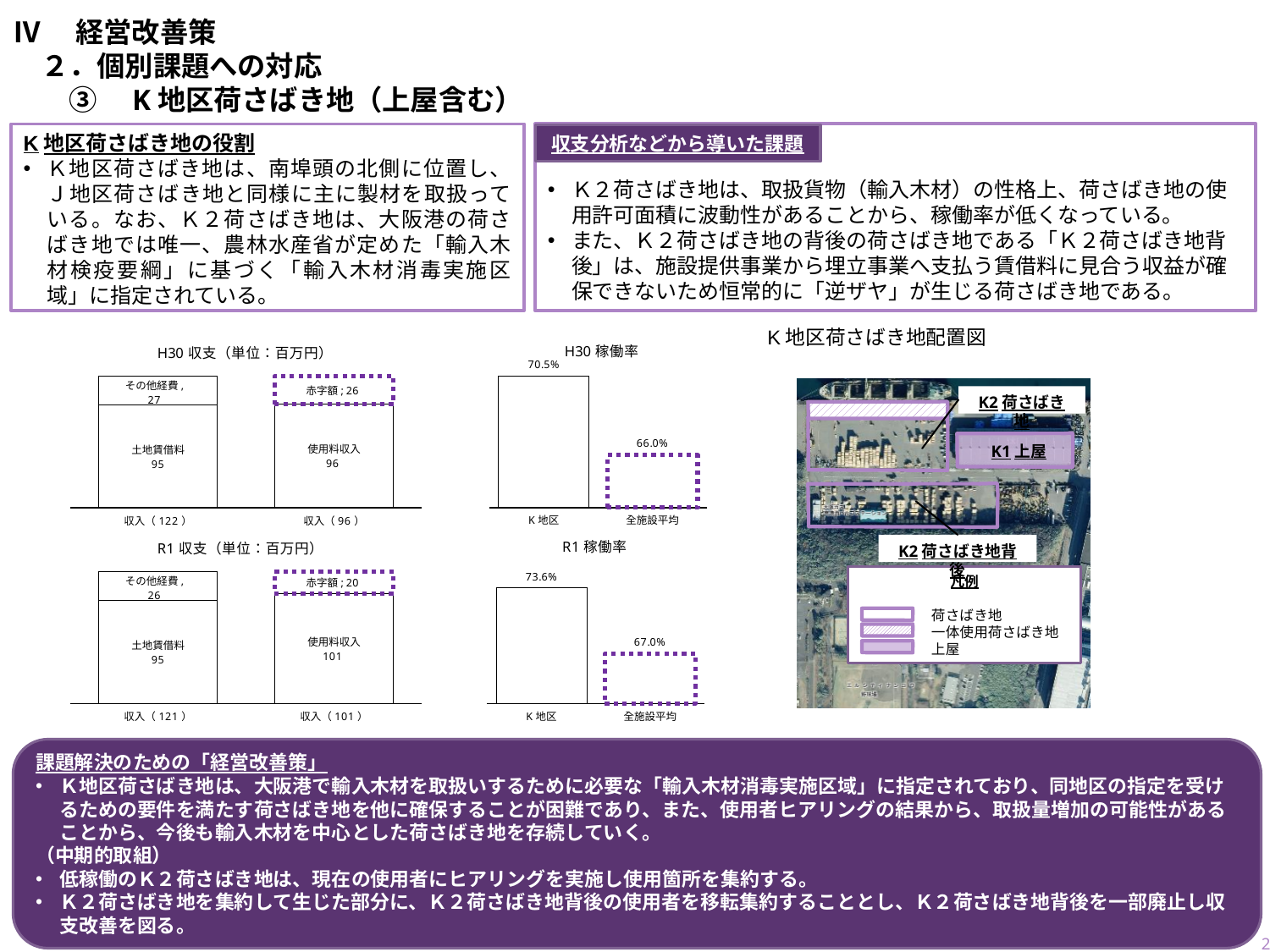
In the R1 稼働率 chart, what is the difference between K地区 and 全施設平均? 6.6% In the H30 稼働率 chart, what is the value for K地区? 70.5% What kind of chart is the H30 稼働率 chart? Bar chart In the H30 収支 chart, what is the value of 赤字額? 26 In the H30 収支 chart, what is the total of the left stacked bar (その他経費 plus 土地賃借料)? 122 In the H30 稼働率 chart, what is the value for 全施設平均? 66.0% In the R1 収支 chart, what is the value of 使用料収入? 101 How many categories are shown on the x axis of the R1 稼働率 chart? 2 In the R1 収支 chart, what is the difference between 土地賃借料 and その他経費? 69 In the H30 収支 chart, what is the value of 土地賃借料? 95 In the R1 収支 chart, what is the value of その他経費? 26 In the R1 稼働率 chart, which category is higher, K地区 or 全施設平均? K地区